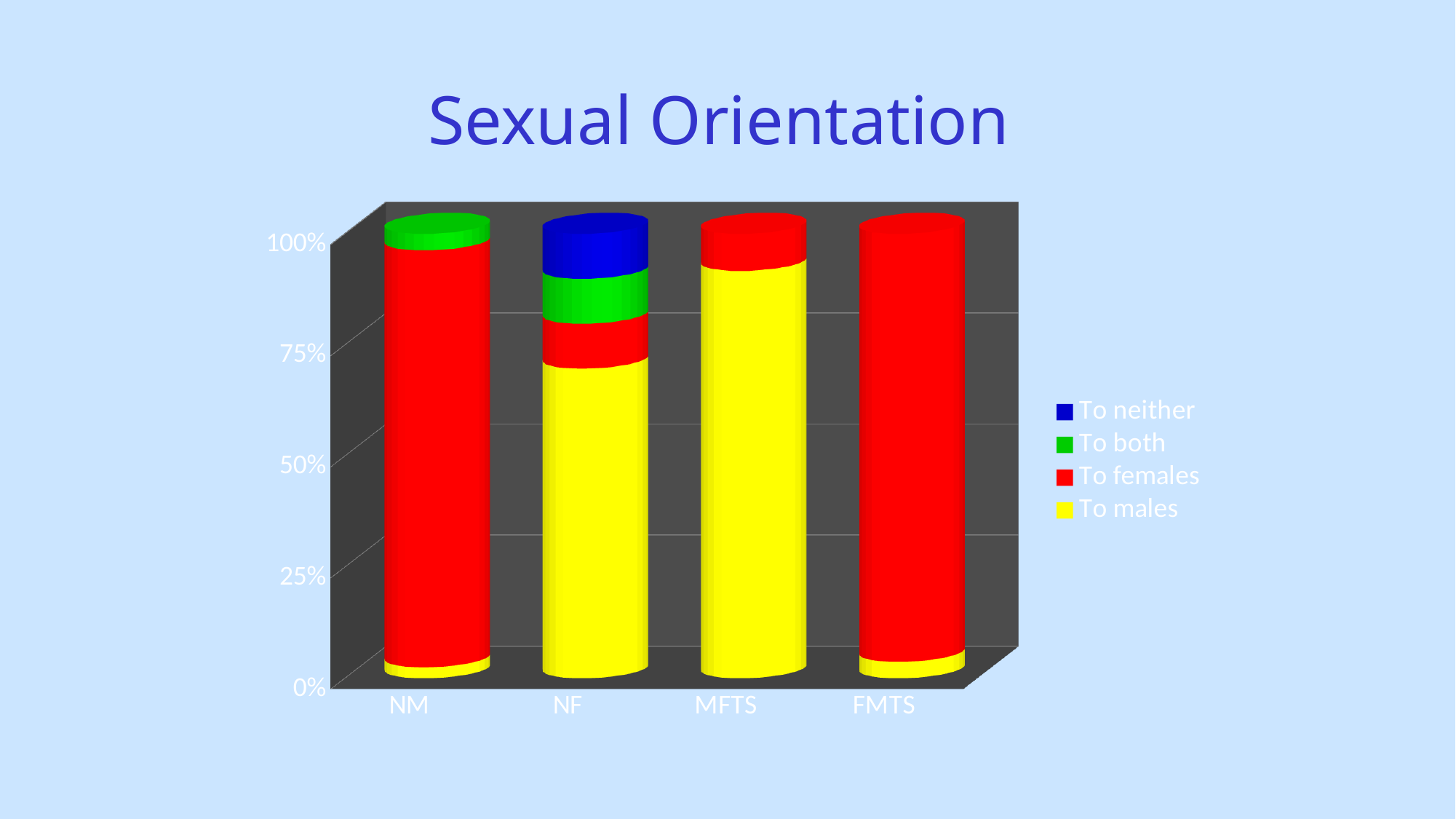
Is the 'To males' share for MFTS greater or less than 75%? greater Which category is the only one with a 'To neither' segment? NF Is the 'To both' share for NF greater or less than 25%? less How many categories are shown on the x axis of the chart? 4 Which category has the largest 'To males' share? MFTS Which has the larger 'To females' share, NM or NF? NM Is the 'To females' share for NM greater or less than 75%? greater What is the title of the chart? Sexual Orientation What kind of chart is shown on the slide? Stacked bar chart How many series does the legend list? 4 Which series is shown in yellow in the legend? To males